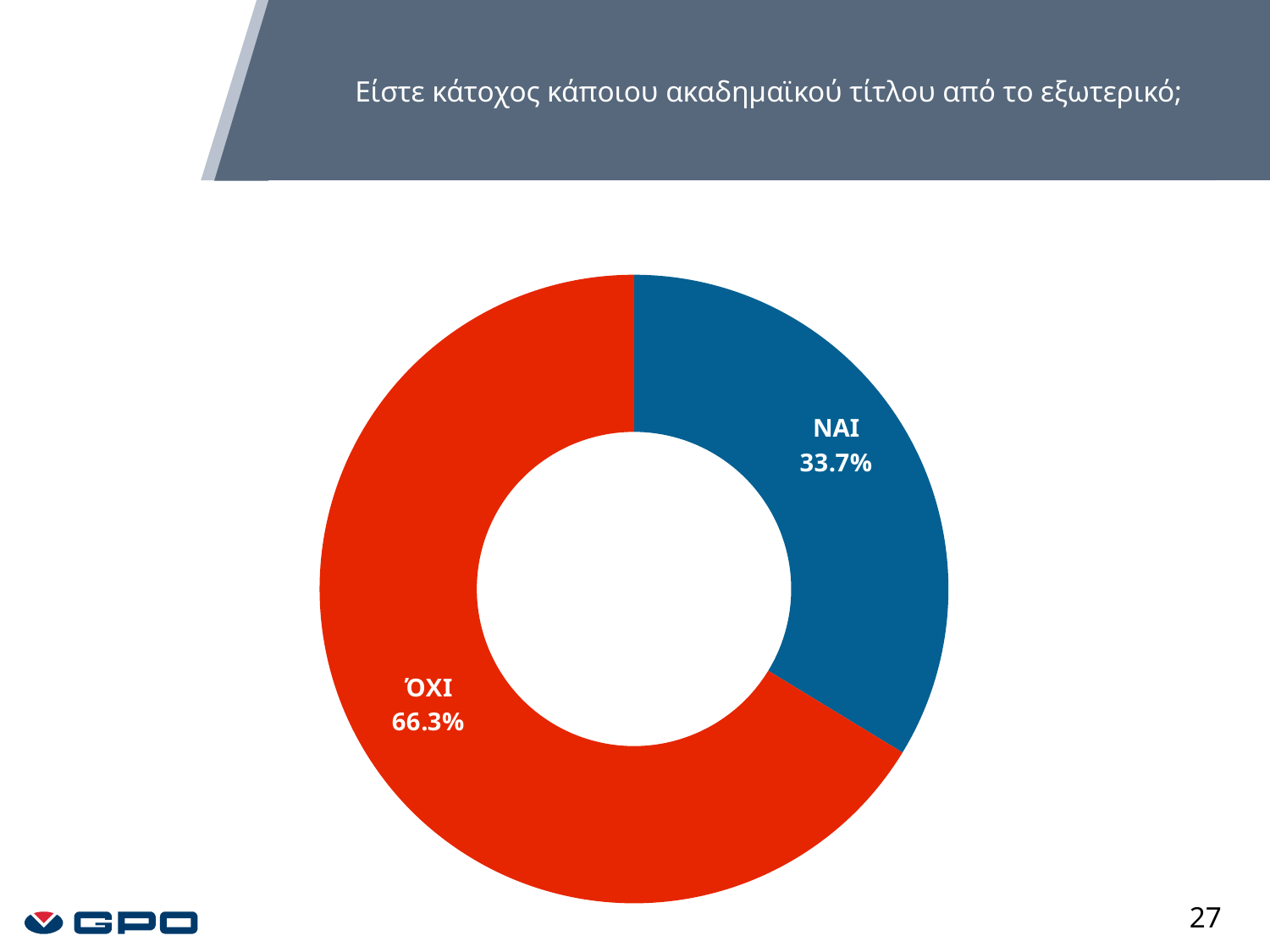
How many categories are shown in the chart? 2 Which response has the smallest share of the chart? ΝΑΙ What share of the pie does the ΌΧΙ slice represent? 66.3% What kind of chart is shown on the slide? Pie chart (doughnut) What percentage of respondents answered ΌΧΙ? 66.3% What is the difference in percentage points between ΌΧΙ and ΝΑΙ? 32.6 What percentage of respondents answered ΝΑΙ? 33.7% Which is larger, the share for ΝΑΙ or the share for ΌΧΙ? ΌΧΙ What is the title of the chart on the slide? Είστε κάτοχος κάποιου ακαδημαϊκού τίτλου από το εξωτερικό; Which response has the largest share of the chart? ΌΧΙ What colour is the ΝΑΙ slice? Blue